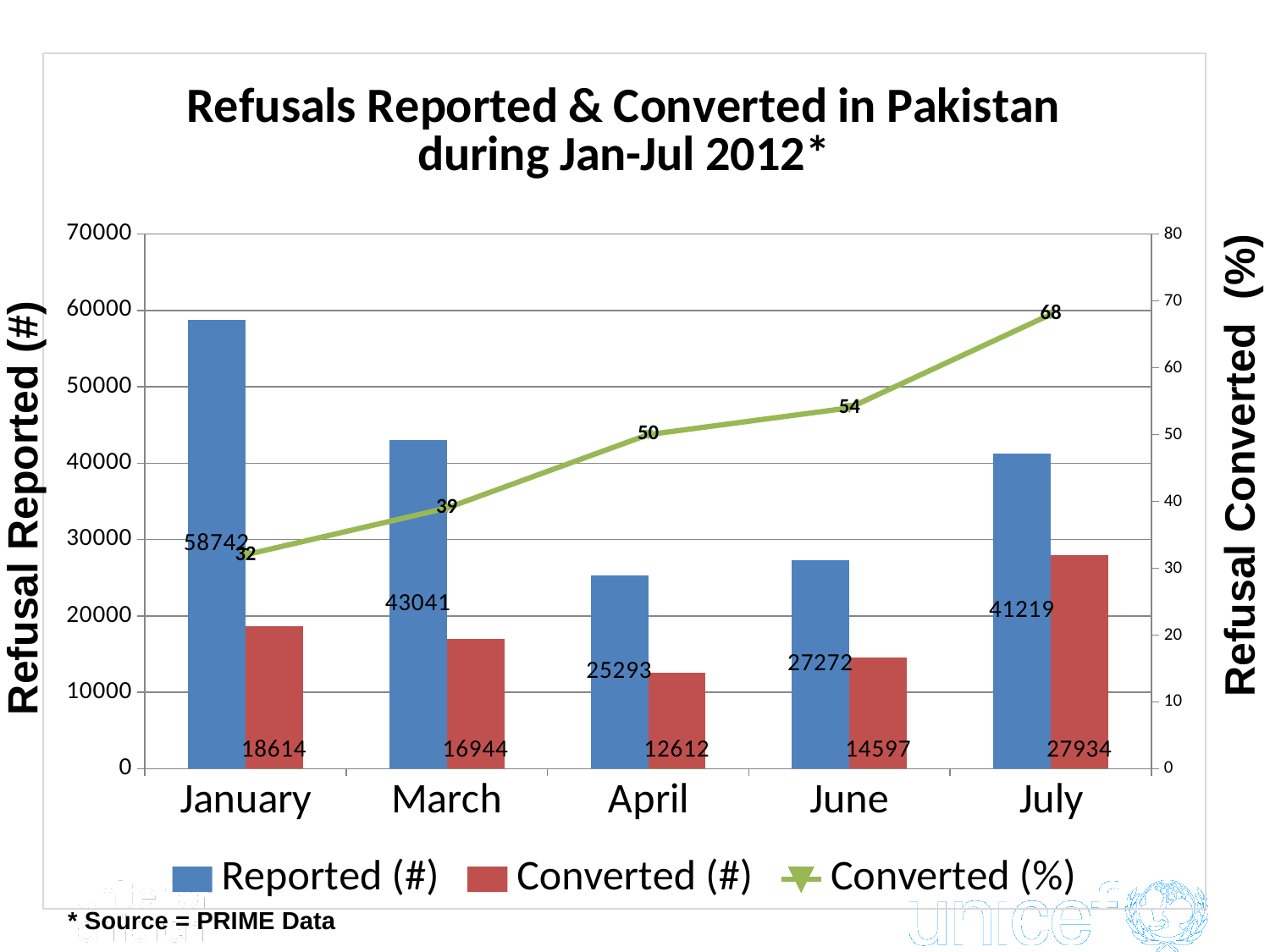
What is the difference between Reported (#) and Converted (#) for March? 26097 What is the Converted (%) value for April? 50 What kind of chart is this? Combined bar and line chart Which month has the highest Reported (#) value? January How many series does the legend list? 3 Which is larger, the Converted (#) value for June or for January? January What is the value of Converted (#) for July? 27934 What is the value of Reported (#) for January? 58742 Which month has the lowest Converted (#) value? April Does the Converted (%) line rise or fall from January to July? rise What is the title of the chart? Refusals Reported & Converted in Pakistan during Jan-Jul 2012* How many months are shown on the x axis? 5